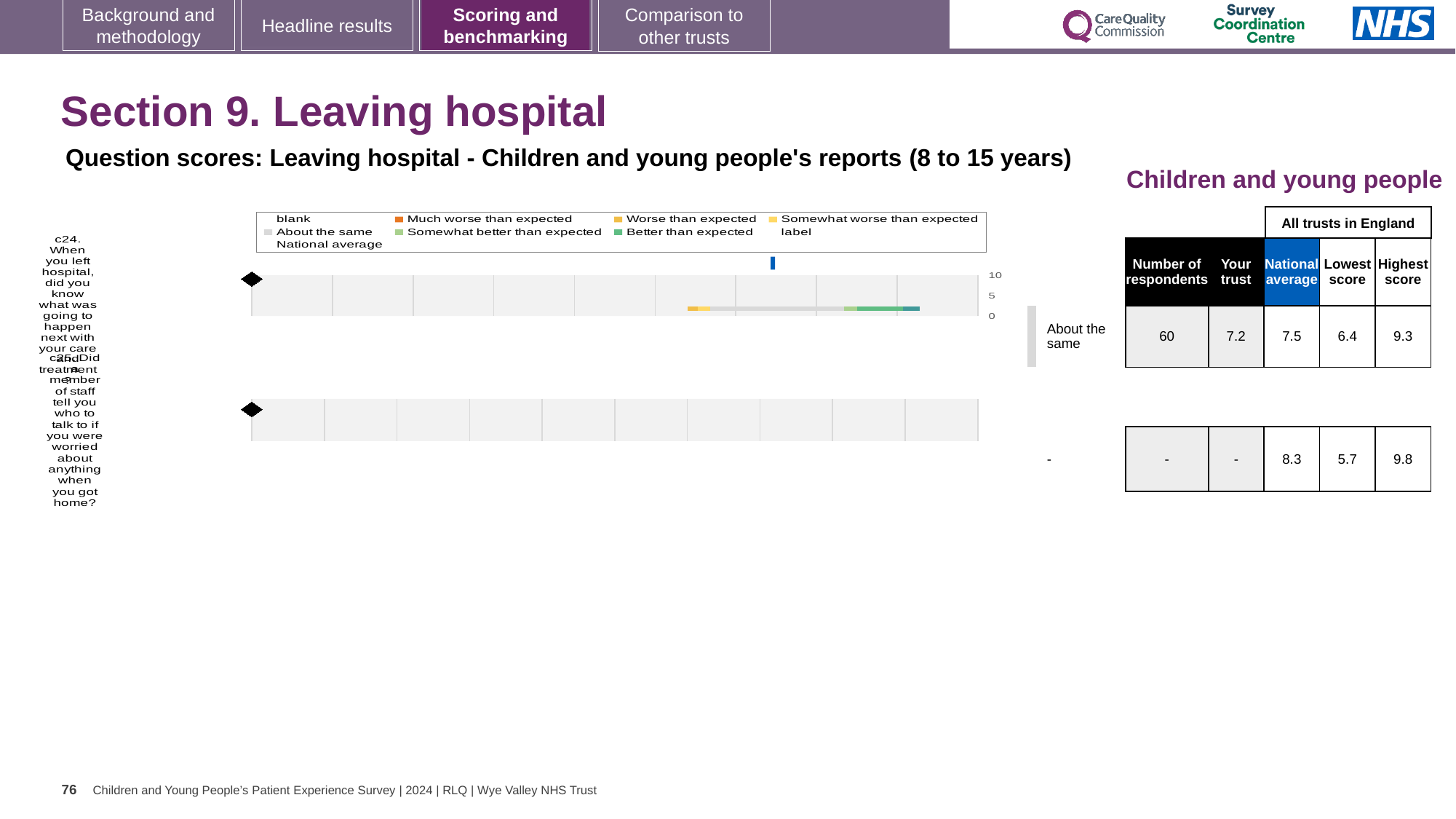
For question c24, which is larger: the 'Your trust' score or the national average? National average What is the lowest score among all trusts in England for question c25? 5.7 What kind of chart is used to show the question scores on this slide? bar chart How many respondents answered question c24? 60 Which question has the higher national average score, c24 or c25? c25 What is the 'Your trust' score for question c24? 7.2 How many questions (categories) are plotted in the chart? 2 What is the highest score among all trusts in England for question c25? 9.8 What is the national average score for question c24? 7.5 What is the difference between the highest and lowest trust scores for question c24? 2.9 Which benchmark category is shown for question c24 (When you left hospital, did you know what was going to happen next with your care and treatment)? About the same